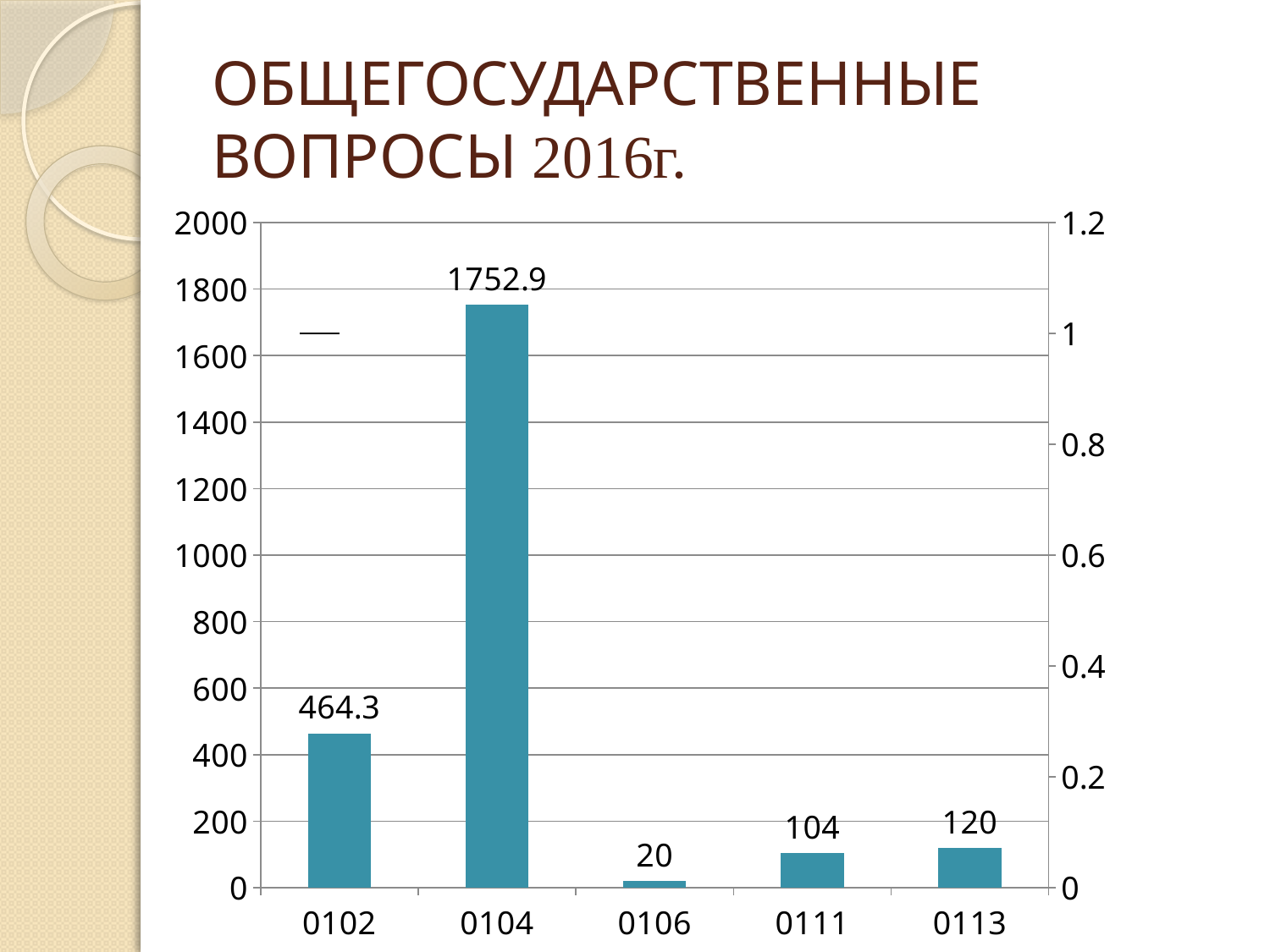
What is the difference between the values for 0104 and 0102? 1288.6 Which category has the lowest value? 0106 What is the difference between the values for 0113 and 0111? 16 What is the value for category 0104? 1752.9 What kind of chart is shown on the slide? bar chart How many categories are shown on the x axis? 5 What is the value for category 0113? 120 Which is larger, the value for 0113 or the value for 0111? 0113 What is the value for category 0102? 464.3 What is the value for category 0106? 20 Which category has the highest value? 0104 What is the value for category 0111? 104